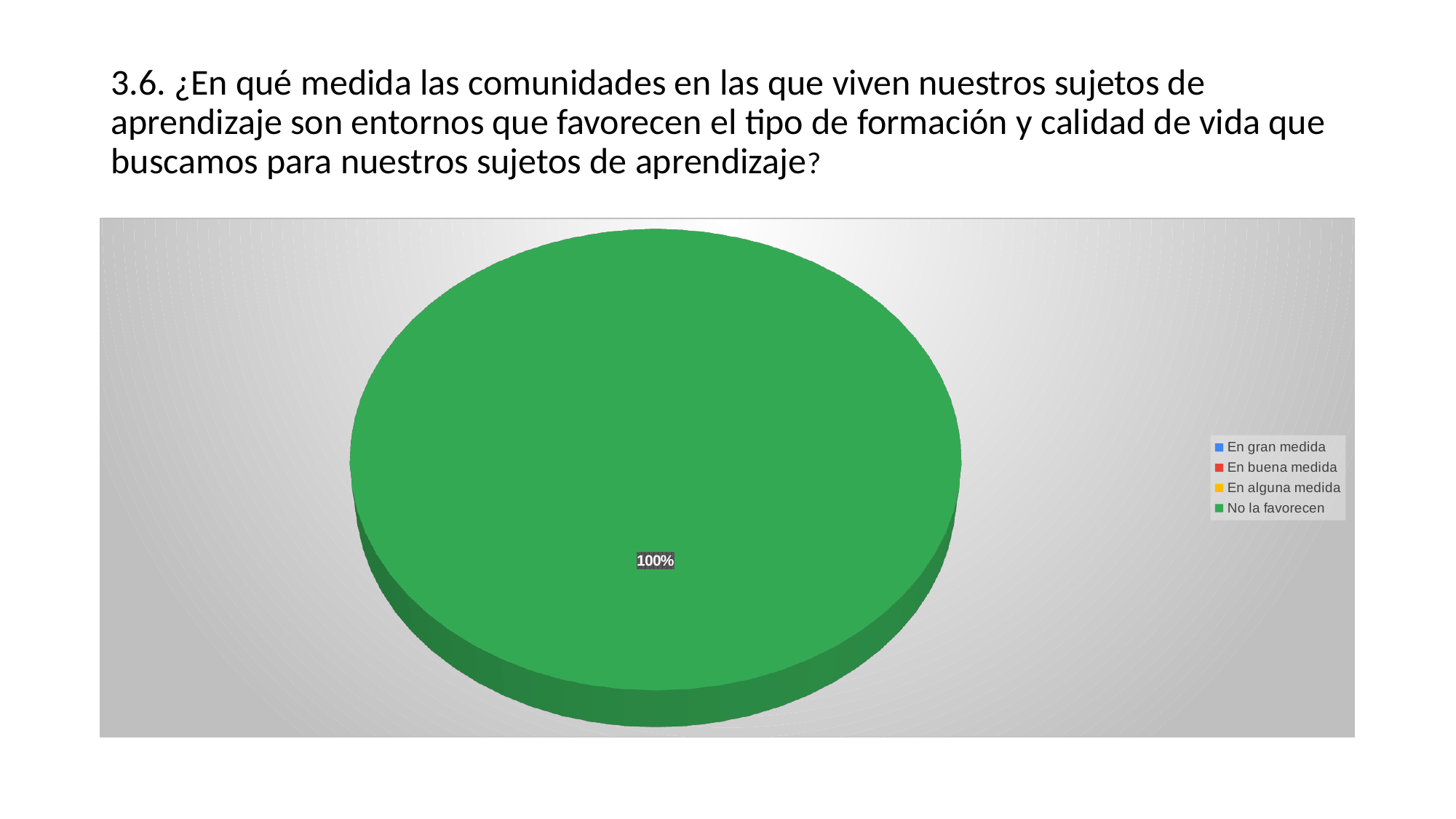
What share of the pie does "No la favorecen" take? 100% What kind of chart is shown on the slide? pie chart Which legend entry is shown in green? No la favorecen What is the data label printed on the pie slice? 100% How many slices are visible in the pie? 1 Which category has the largest share of the pie? No la favorecen How many entries does the legend list? 4 Is the share for "No la favorecen" greater or less than 50%? greater Which legend entry is shown in blue? En gran medida